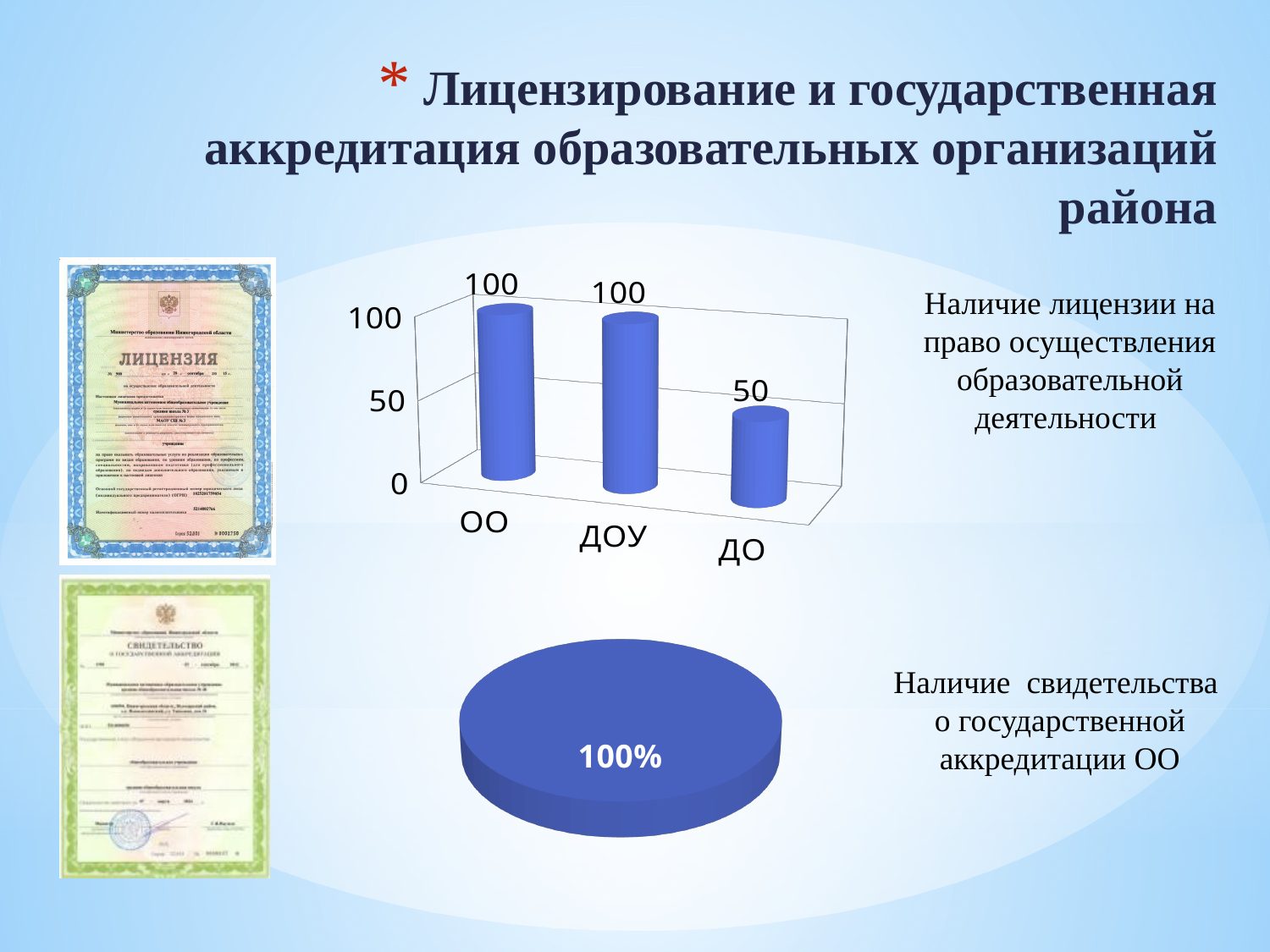
In the top bar chart, do the values rise or fall from ДОУ to ДО? fall In the bottom pie chart, what share is shown on the slice? 100% In the top bar chart, which category has the lowest value? ДО In the top bar chart, what is the value for ДО? 50 How many categories are shown in the top bar chart? 3 What kind of chart is the bottom chart on the slide? pie chart In the top bar chart, what is the difference between the values for ОО and ДО? 50 What kind of chart is the top chart on the slide? bar chart In the top bar chart, what is the value for ОО? 100 In the top bar chart, which is larger, the value for ДОУ or the value for ДО? ДОУ How many slices does the bottom pie chart have? 1 In the top bar chart, what is the value for ДОУ? 100